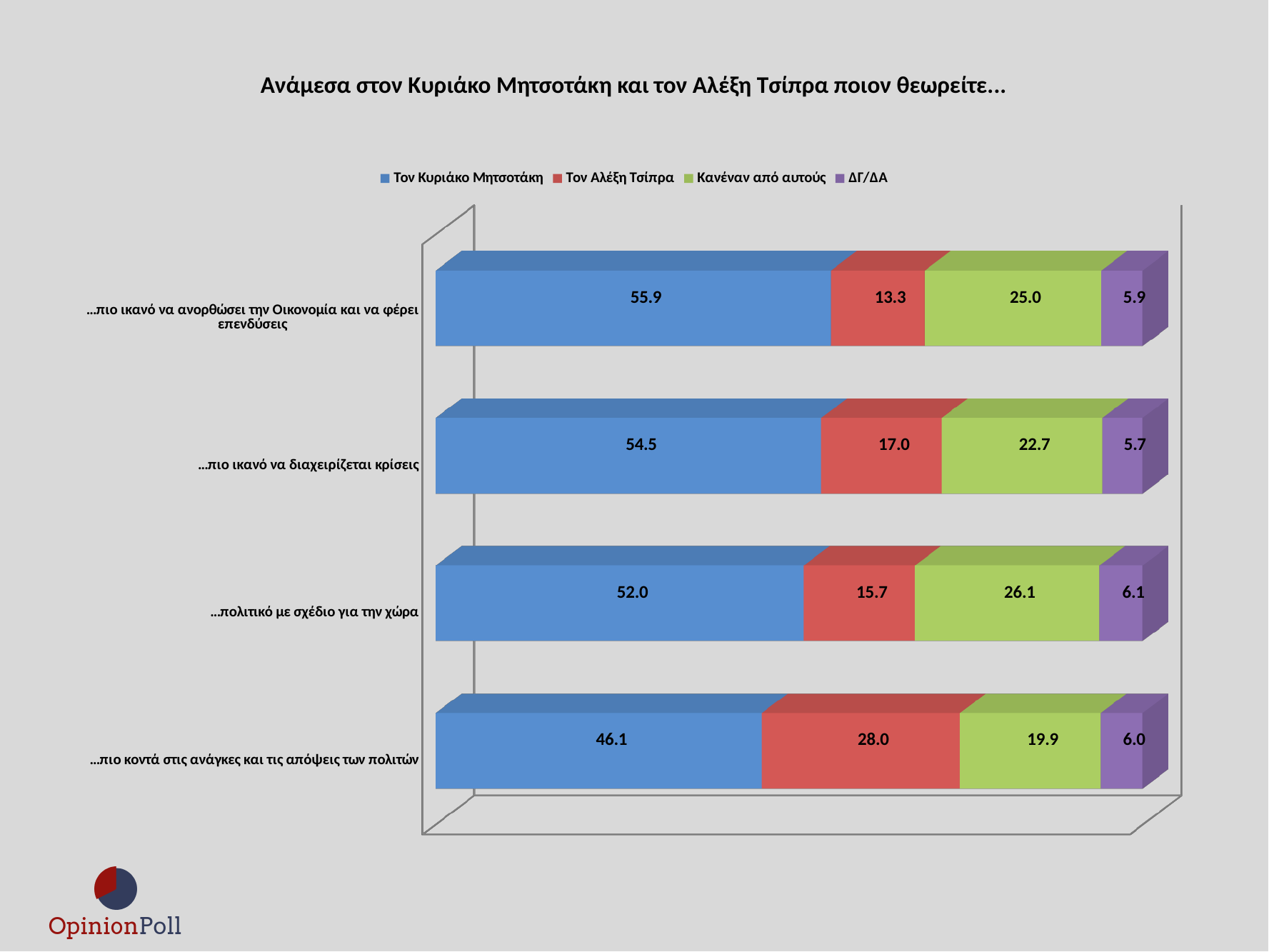
What is the value for "ΔΓ/ΔΑ" in the category "...πιο ικανό να διαχειρίζεται κρίσεις"? 5.7 Which is larger in the category "...πιο ικανό να διαχειρίζεται κρίσεις": the value for "Τον Αλέξη Τσίπρα" or for "Κανέναν από αυτούς"? Κανέναν από αυτούς How many series does the legend list? 4 In which category does "Τον Κυριάκο Μητσοτάκη" have the highest value? ...πιο ικανό να ανορθώσει την Οικονομία και να φέρει επενδύσεις What is the value for "Τον Αλέξη Τσίπρα" in the category "...πιο κοντά στις ανάγκες και τις απόψεις των πολιτών"? 28.0 What is the value for "Κανέναν από αυτούς" in the category "...πολιτικό με σχέδιο για την χώρα"? 26.1 What kind of chart is shown on the slide? Stacked bar chart What is the difference between the values for "Τον Κυριάκο Μητσοτάκη" and "Τον Αλέξη Τσίπρα" in the category "...πιο κοντά στις ανάγκες και τις απόψεις των πολιτών"? 18.1 How many categories are shown on the chart? 4 In which category does "Τον Αλέξη Τσίπρα" have the lowest value? ...πιο ικανό να ανορθώσει την Οικονομία και να φέρει επενδύσεις What is the value for "Τον Κυριάκο Μητσοτάκη" in the category "...πιο ικανό να ανορθώσει την Οικονομία και να φέρει επενδύσεις"? 55.9 What is the total of the stacked bar for "...πολιτικό με σχέδιο για την χώρα"? 99.9